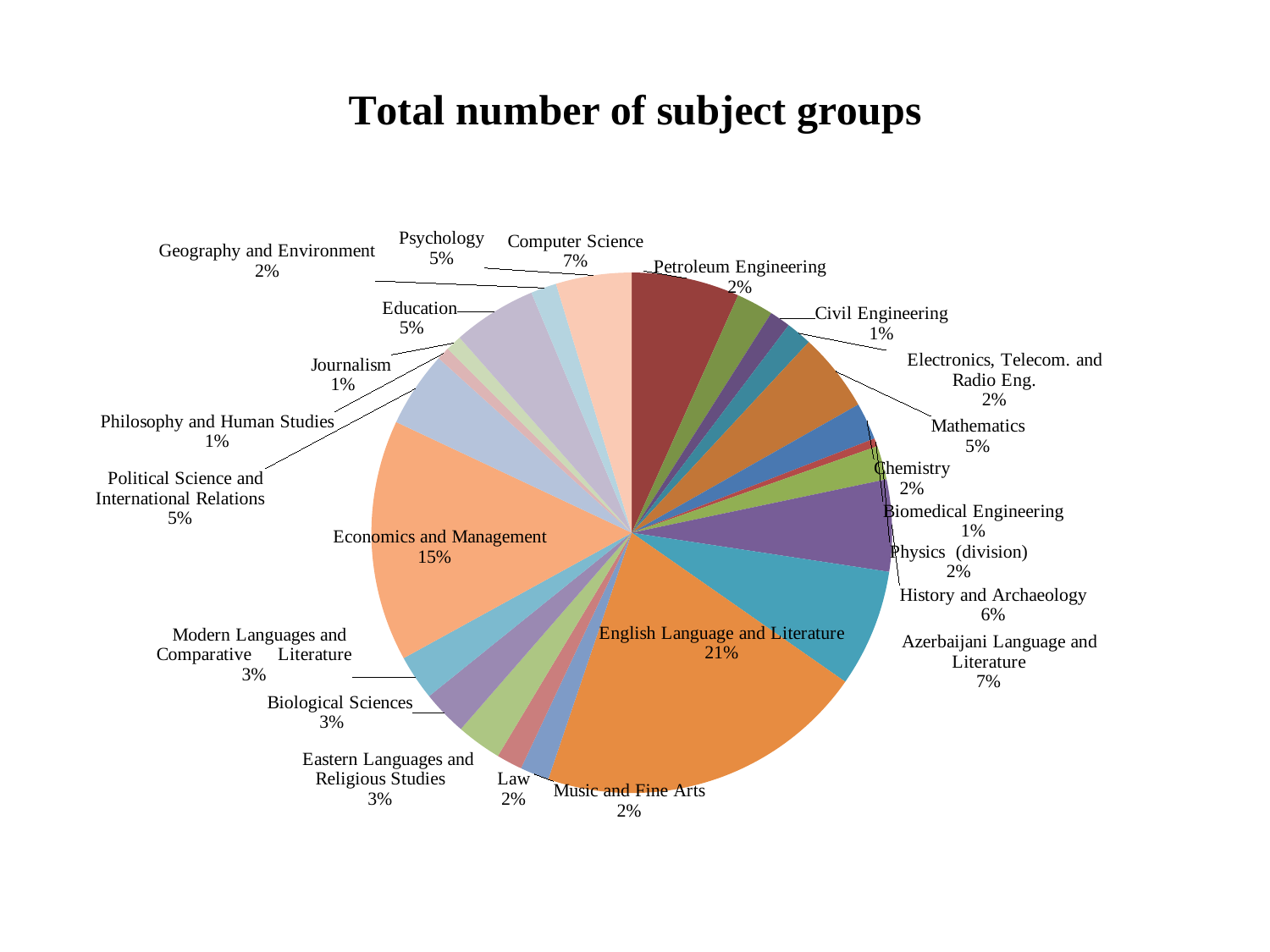
What percentage is shown for Biomedical Engineering? 1% What percentage is shown for History and Archaeology? 6% Which is larger, the share for Computer Science or the share for Mathematics? Computer Science Which subject group has the largest share of the pie? English Language and Literature What is the difference in percentage points between English Language and Literature and Economics and Management? 6 How many subject groups are shown in the pie chart? 23 What percentage is shown for Mathematics? 5% Which is larger, the share for Azerbaijani Language and Literature or the share for History and Archaeology? Azerbaijani Language and Literature What is the title of the chart? Total number of subject groups What kind of chart is shown on the slide? Pie chart What percentage is shown for Economics and Management? 15% What share of the pie does English Language and Literature have? 21%